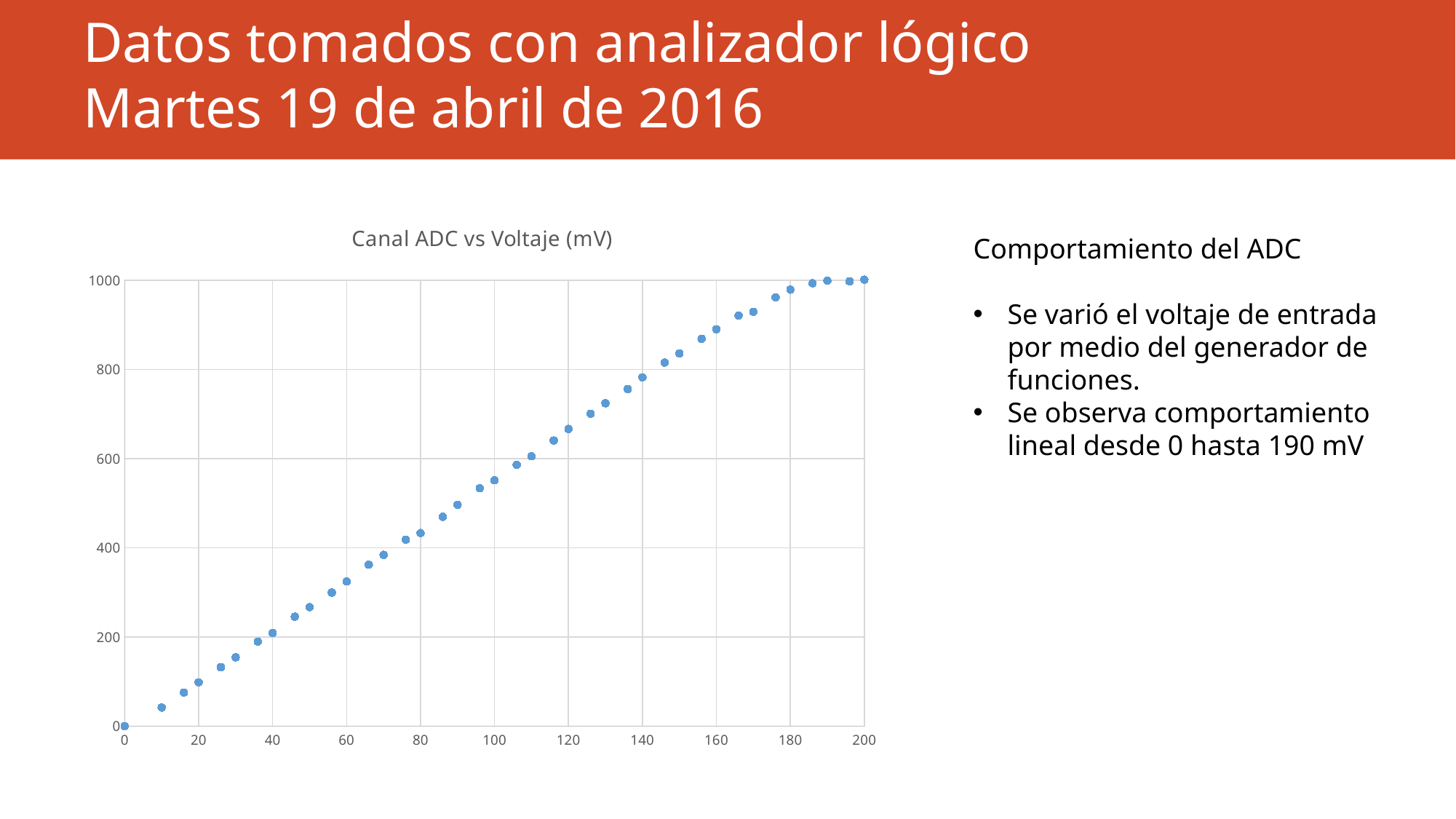
Is the plotted value at x = 140 greater or less than 600? greater Is the plotted value at x = 60 greater or less than 200? greater Which has the larger plotted value, x = 80 or x = 120? x = 120 Is the plotted value at x = 180 greater or less than 800? greater What is the plotted value at x = 0? 0 What is the title of the chart? Canal ADC vs Voltaje (mV) What is the highest tick value shown on the y axis? 1000 Do the plotted values rise or fall as the x axis increases from 0 to 200? rise What kind of chart is shown on the slide? scatter chart At which x value is the plotted value lowest? 0